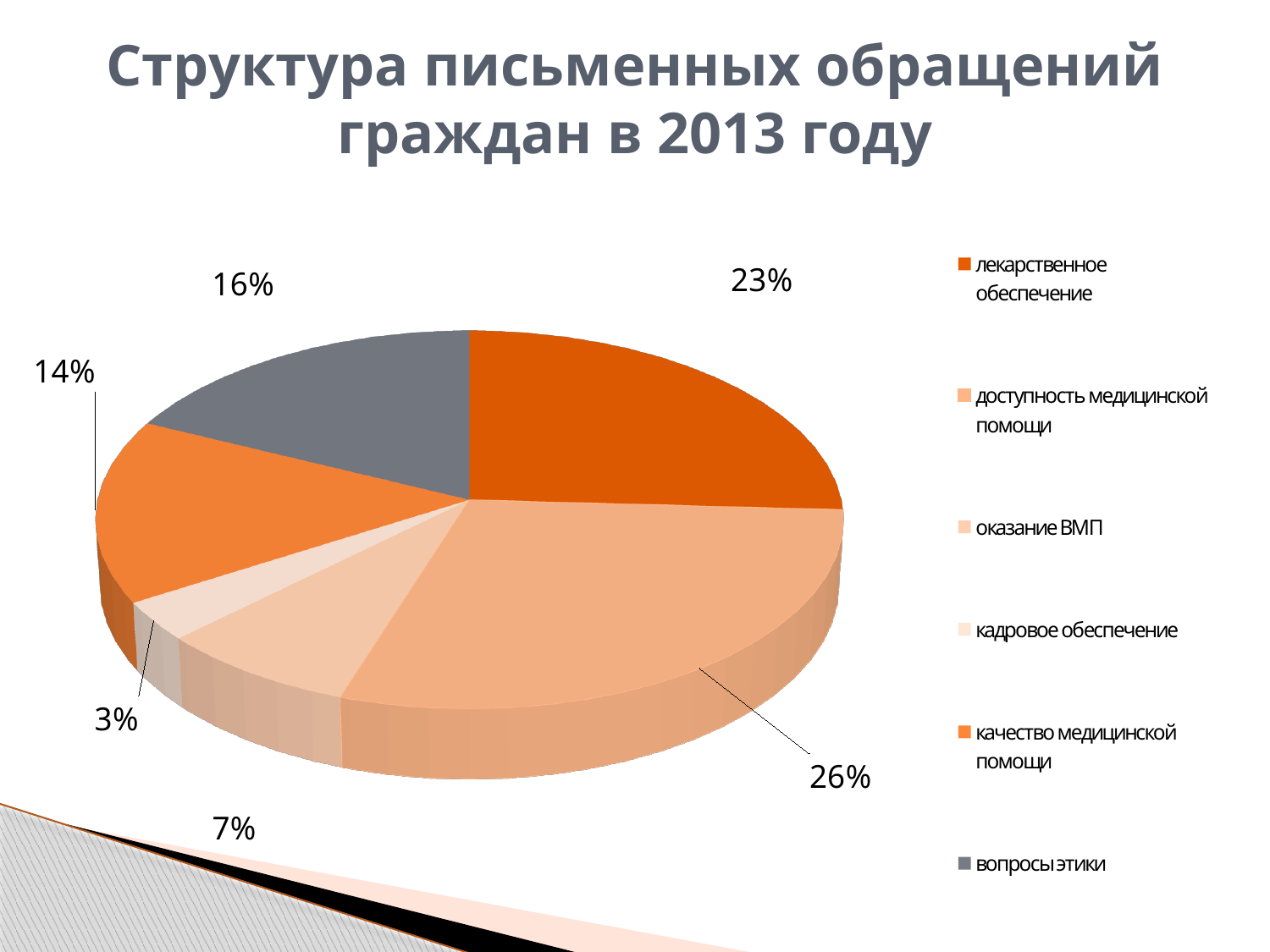
How many categories does the legend of the pie chart list? 6 What share of the pie is labelled for 'лекарственное обеспечение'? 23% What share of the pie is labelled for 'доступность медицинской помощи'? 26% What is the difference in percentage points between 'вопросы этики' and 'качество медицинской помощи'? 2% What share of the pie is labelled for 'кадровое обеспечение'? 3% What is the title of the chart on the slide? Структура письменных обращений граждан в 2013 году Which is larger: the slice for 'лекарственное обеспечение' or the slice for 'вопросы этики'? лекарственное обеспечение What kind of chart is shown on the slide? pie chart Which category has the smallest slice of the pie? кадровое обеспечение Which category has the largest slice of the pie? доступность медицинской помощи